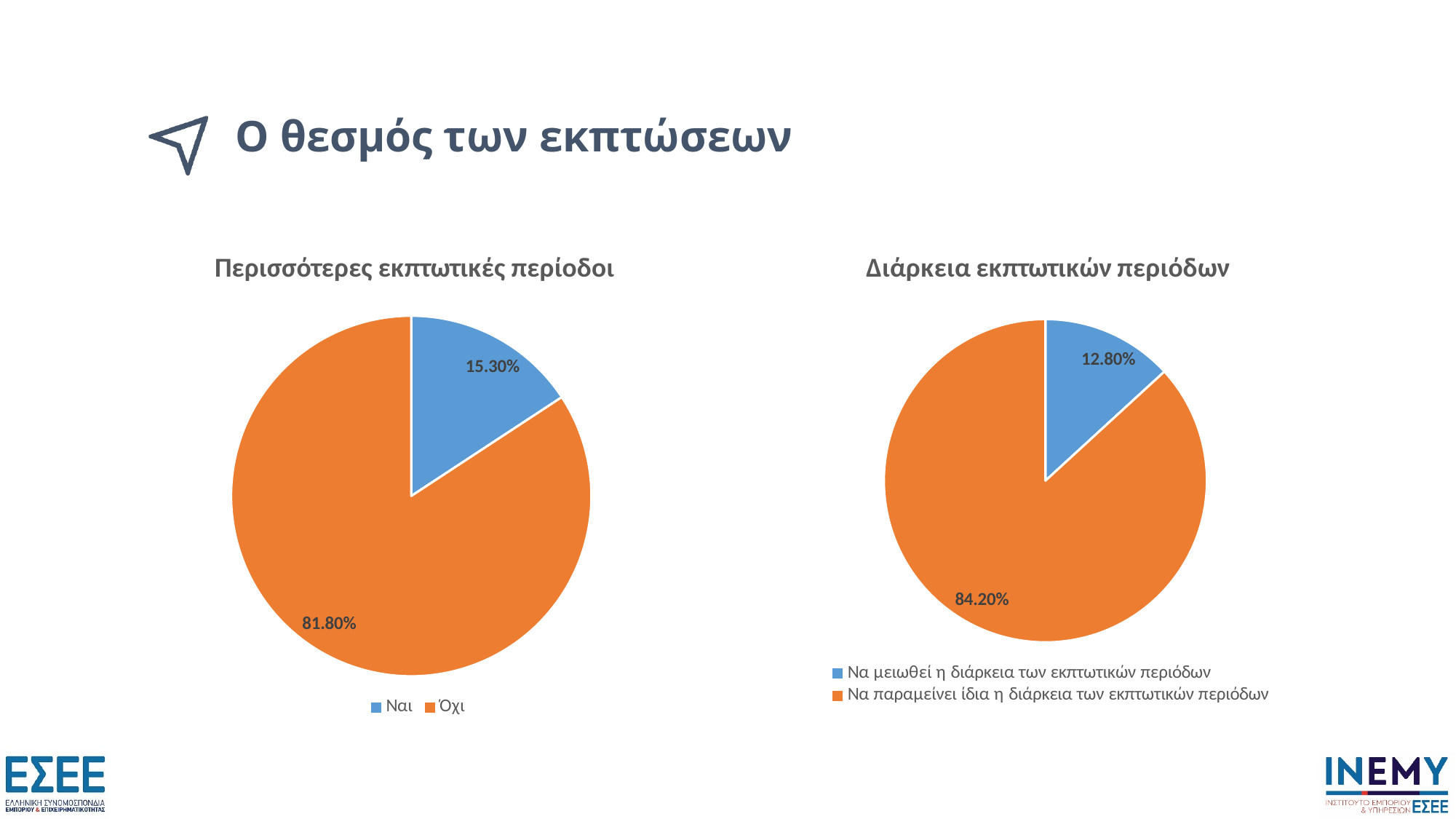
In the chart titled 'Διάρκεια εκπτωτικών περιόδων', what is the difference between the two slice values? 71.40% In the chart titled 'Περισσότερες εκπτωτικές περίοδοι', what is the difference between the 'Όχι' and 'Ναι' values? 66.50% How many categories does the legend of the chart titled 'Περισσότερες εκπτωτικές περίοδοι' list? 2 Which is larger: the 'Ναι' slice in the left chart or the 'Να μειωθεί η διάρκεια των εκπτωτικών περιόδων' slice in the right chart? Ναι (left chart) In the chart titled 'Περισσότερες εκπτωτικές περίοδοι', what is the value for 'Όχι'? 81.80% In the chart titled 'Περισσότερες εκπτωτικές περίοδοι', which category has the largest slice? Όχι In the chart titled 'Διάρκεια εκπτωτικών περιόδων', what is the value for 'Να μειωθεί η διάρκεια των εκπτωτικών περιόδων'? 12.80% In the chart titled 'Διάρκεια εκπτωτικών περιόδων', what is the value for 'Να παραμείνει ίδια η διάρκεια των εκπτωτικών περιόδων'? 84.20% What type of chart is the chart titled 'Διάρκεια εκπτωτικών περιόδων'? Pie chart In the chart titled 'Διάρκεια εκπτωτικών περιόδων', what colour is the slice for 'Να παραμείνει ίδια η διάρκεια των εκπτωτικών περιόδων'? Orange In the chart titled 'Περισσότερες εκπτωτικές περίοδοι', what is the value for 'Ναι'? 15.30% In the chart titled 'Διάρκεια εκπτωτικών περιόδων', which category has the smallest slice? Να μειωθεί η διάρκεια των εκπτωτικών περιόδων